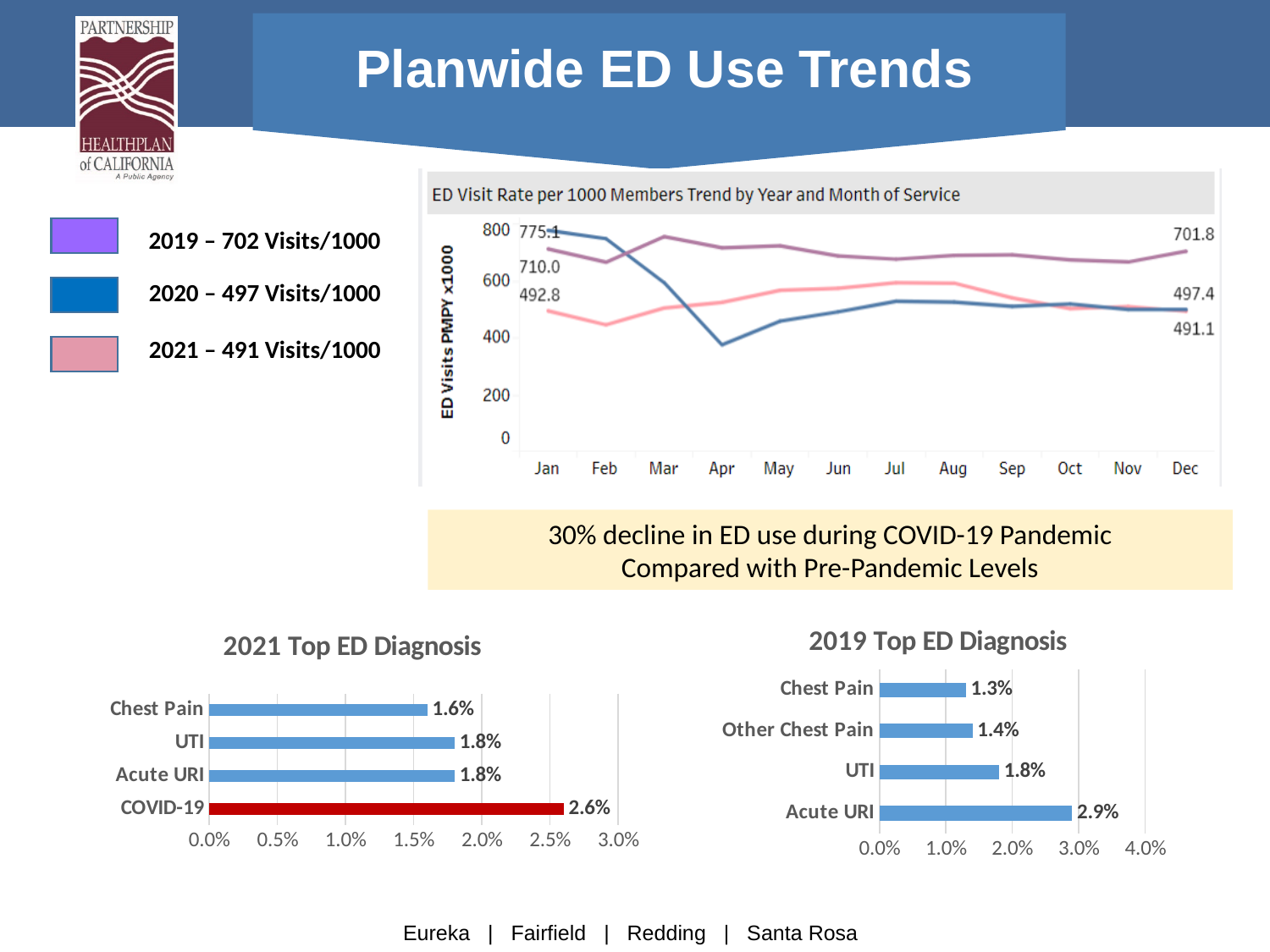
In the 2019 Top ED Diagnosis chart, what is the value for Acute URI? 2.9% In the 2021 Top ED Diagnosis chart, what is the value for COVID-19? 2.6% In the ED Visit Rate per 1000 Members Trend chart, what is the labelled value at the start of the blue line in Jan? 775.1 In the ED Visit Rate per 1000 Members Trend chart, what is the labelled value at the end of the purple line in Dec? 701.8 In the 2021 Top ED Diagnosis chart, which diagnosis has the highest value? COVID-19 In the 2019 Top ED Diagnosis chart, how many diagnoses are shown? 4 In the ED Visit Rate per 1000 Members Trend chart, is the value of the blue line in Apr greater or less than 400? less In the 2021 Top ED Diagnosis chart, what is the difference between the COVID-19 value and the Chest Pain value? 1.0% What kind of chart is the 2021 Top ED Diagnosis chart? Bar chart In the 2019 Top ED Diagnosis chart, which is larger, the value for UTI or the value for Other Chest Pain? UTI In the 2019 Top ED Diagnosis chart, which diagnosis has the lowest value? Chest Pain In the 2021 Top ED Diagnosis chart, which diagnosis has the lowest value? Chest Pain